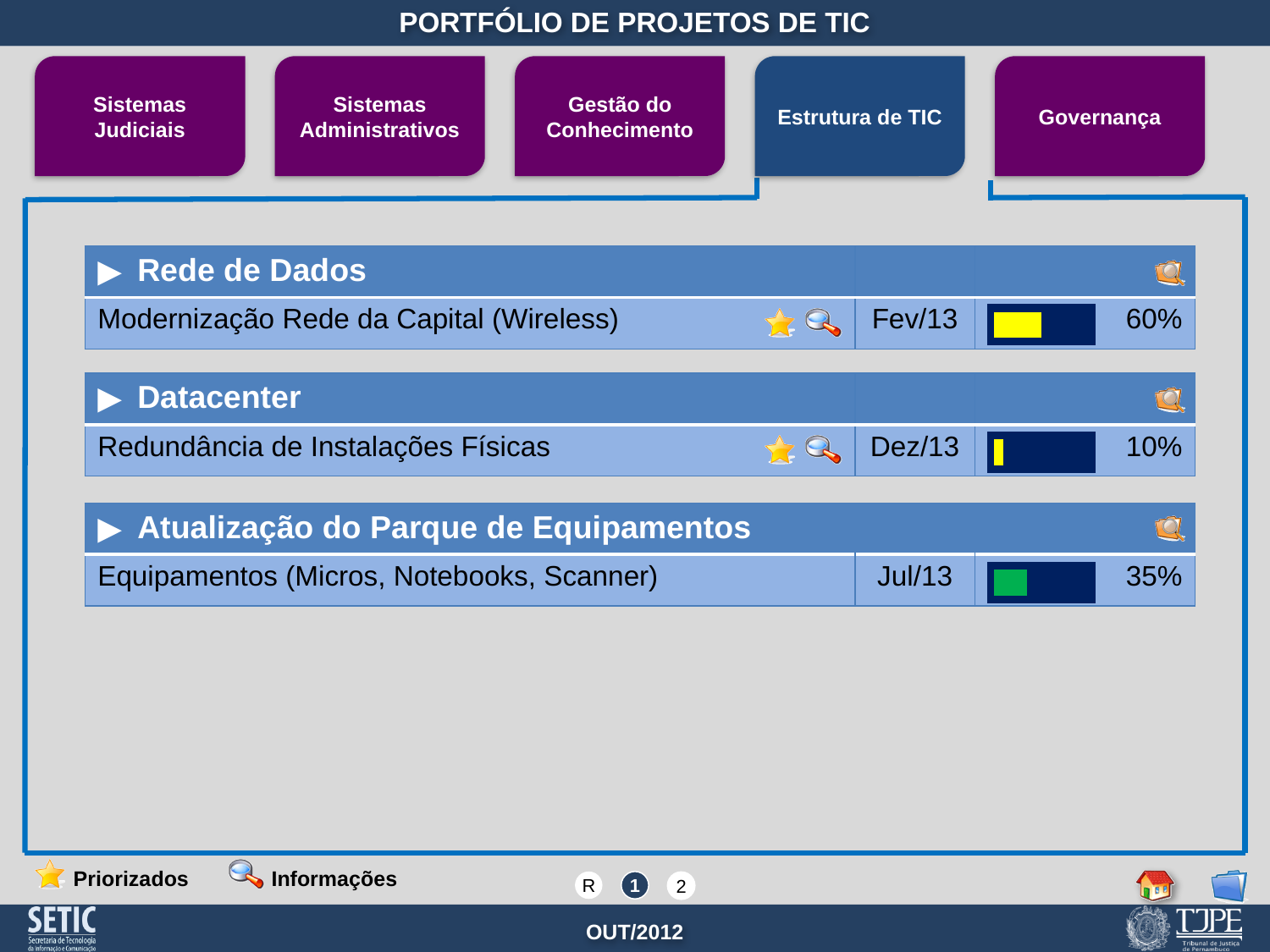
Which project has the highest completion percentage? Modernização Rede da Capital (Wireless) What is the completion percentage shown for Modernização Rede da Capital (Wireless)? 60% Which project has the lowest completion percentage? Redundância de Instalações Físicas What is the difference in completion percentage between Equipamentos (Micros, Notebooks, Scanner) and Redundância de Instalações Físicas? 25% What is the difference in completion percentage between Modernização Rede da Capital (Wireless) and Equipamentos (Micros, Notebooks, Scanner)? 25% What date is shown next to the Redundância de Instalações Físicas project? Dez/13 Which has a higher completion percentage, Redundância de Instalações Físicas or Equipamentos (Micros, Notebooks, Scanner)? Equipamentos (Micros, Notebooks, Scanner) What is the completion percentage shown for Redundância de Instalações Físicas? 10% How many projects have a progress bar on the slide? 3 What kind of chart is used to show project progress on the slide? Bar chart What is the completion percentage shown for Equipamentos (Micros, Notebooks, Scanner)? 35% What colour is the progress bar fill for Equipamentos (Micros, Notebooks, Scanner)? Green